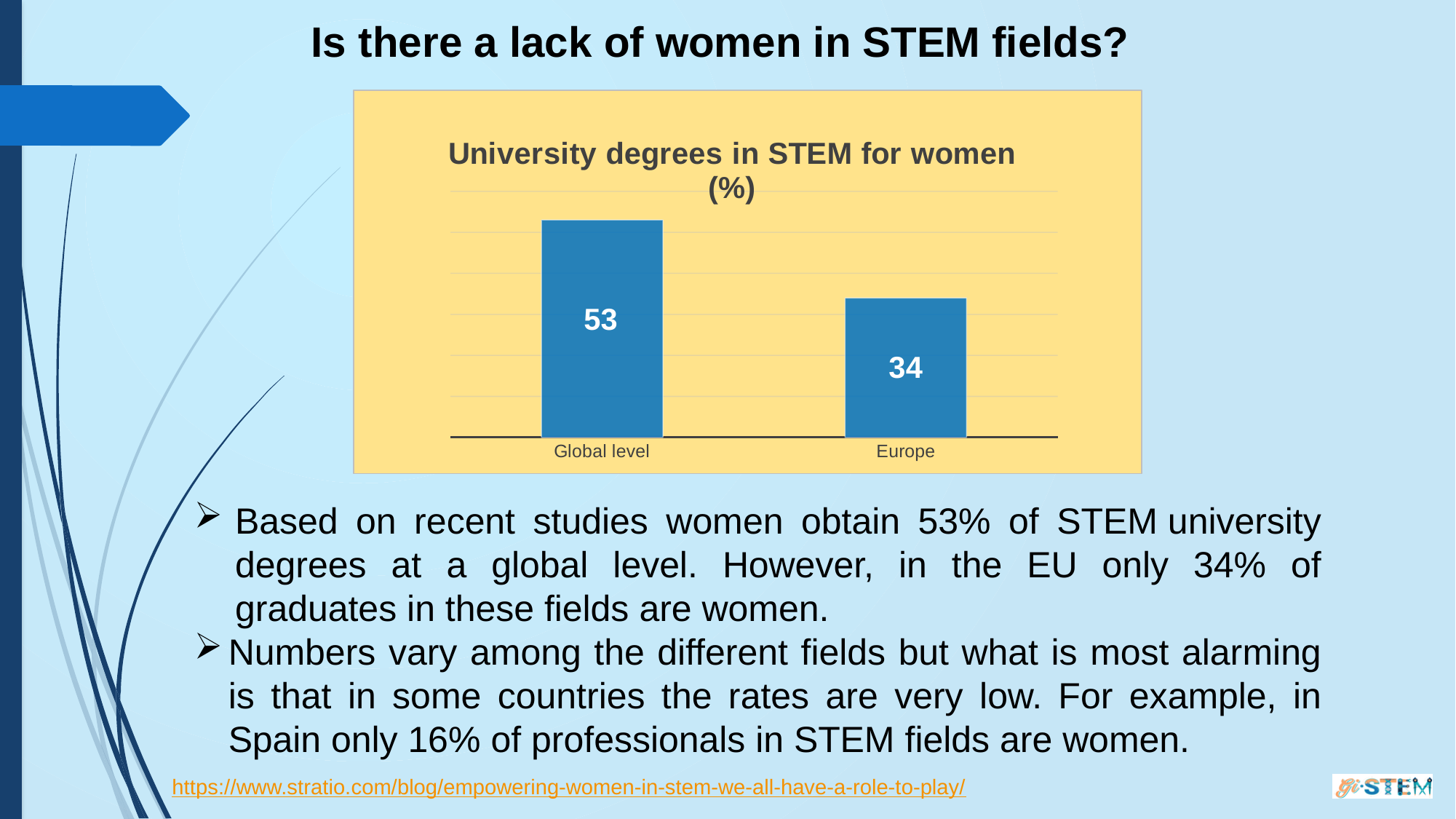
Which category has the highest value? Global level What colour are the bars in the chart? Blue Which is larger, the value for Global level or the value for Europe? Global level What is the value for Global level? 53 What is the title of the chart? University degrees in STEM for women (%) How many categories are shown in the chart? 2 Do the values rise or fall from Global level to Europe? Fall What kind of chart is shown on the slide? Bar chart What is the difference between the values for Global level and Europe? 19 What is the value for Europe? 34 Which category has the lowest value? Europe